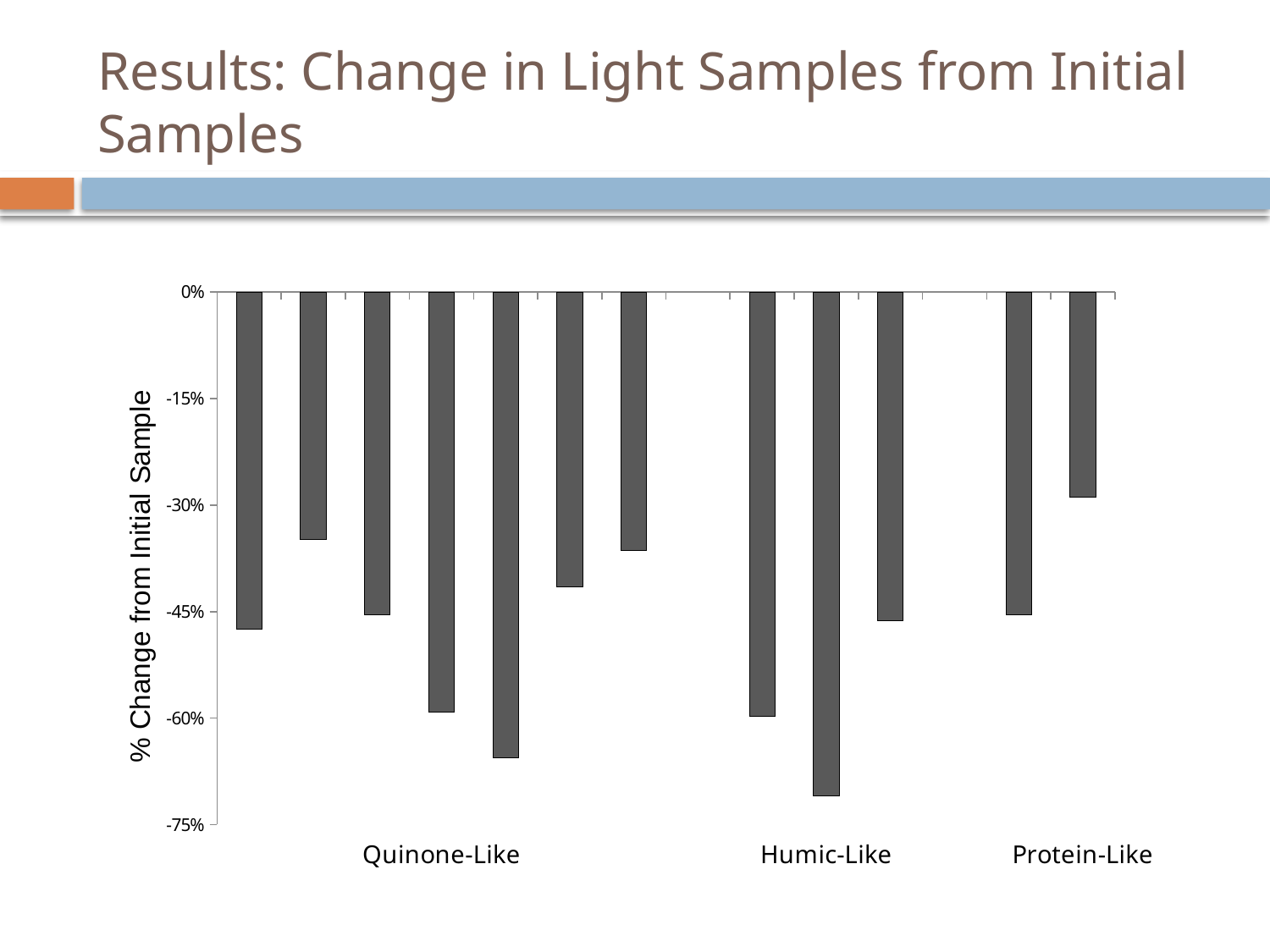
How many category labels are shown on the x axis? 3 What is the title of the vertical axis? % Change from Initial Sample What kind of chart is shown on the slide? bar chart How many bars are in the Humic-Like group? 3 Is the value of the first bar in the Quinone-Like group greater or less than -60%? greater How many bars are plotted in total on the chart? 12 What is the lowest tick value shown on the vertical axis? -75% Which is larger: the first bar in the Humic-Like group or the first bar in the Protein-Like group? the first bar in the Protein-Like group Which group contains the bar with the most negative value on the chart? Humic-Like Is the value of the second bar in the Humic-Like group greater or less than -60%? less